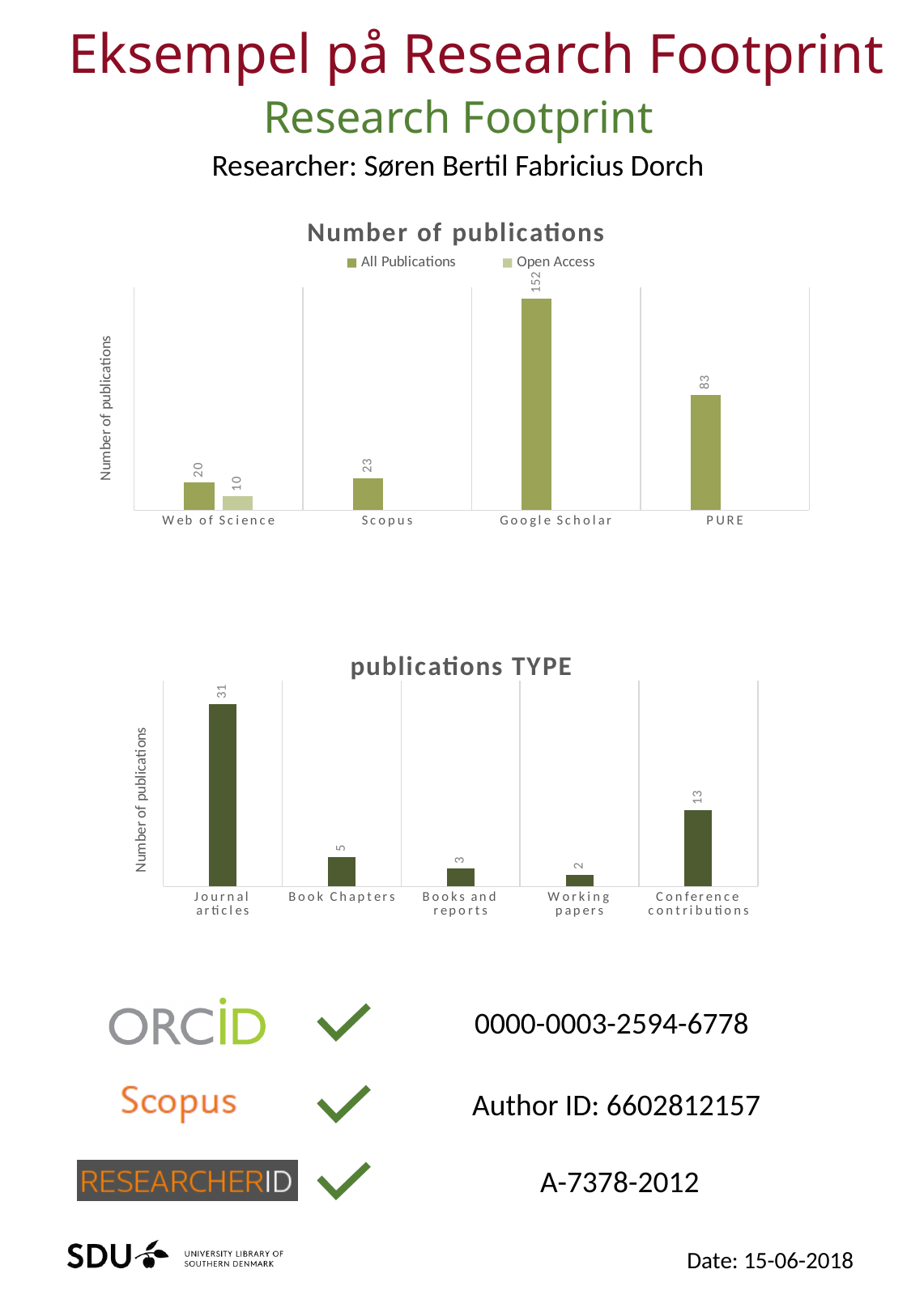
In the 'Number of publications' chart, what is the y-axis title? Number of publications In the 'Number of publications' chart, how many series does the legend list? 2 In the 'Number of publications' chart, what is the Open Access value for Web of Science? 10 In the 'publications TYPE' chart, which category has the lowest value? Working papers In the 'Number of publications' chart, what is the difference between the All Publications values for Google Scholar and PURE? 69 In the 'publications TYPE' chart, how many categories are shown? 5 In the 'Number of publications' chart, which is larger for All Publications: Web of Science or Scopus? Scopus In the 'publications TYPE' chart, what is the difference between Journal articles and Conference contributions? 18 In the 'publications TYPE' chart, what is the value for Journal articles? 31 What kind of chart is the 'publications TYPE' chart? Bar chart In the 'Number of publications' chart, what is the All Publications value for Google Scholar? 152 In the 'Number of publications' chart, which source has the highest number of All Publications? Google Scholar